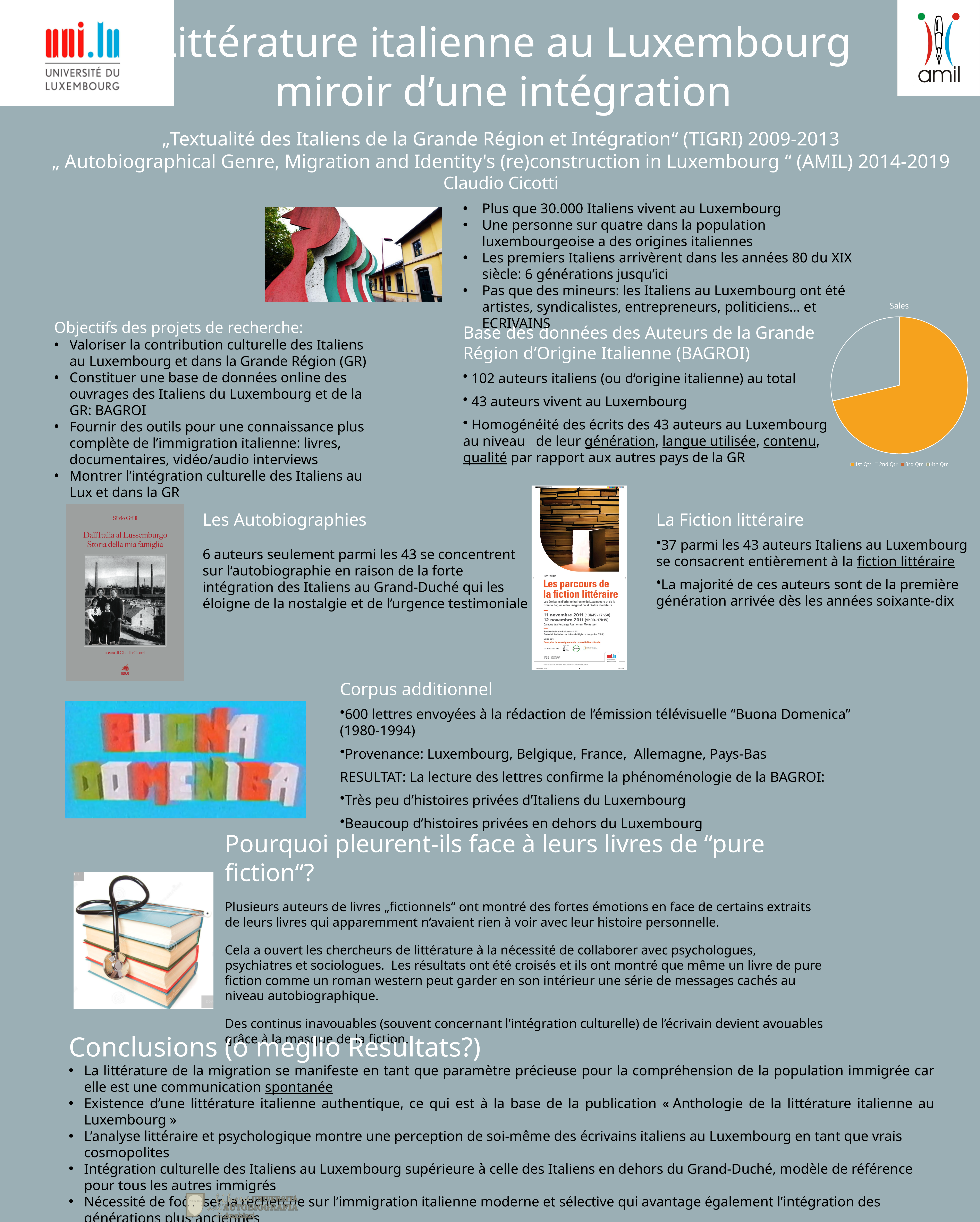
How many entries does the legend of the pie chart list? 4 What kind of chart is shown on the slide? pie chart What are the legend entries of the pie chart? 1st Qtr, 2nd Qtr, 3rd Qtr, 4th Qtr What is the title of the pie chart on the slide? Sales In the pie chart, which slice is larger: the orange slice or the white slice? the orange slice